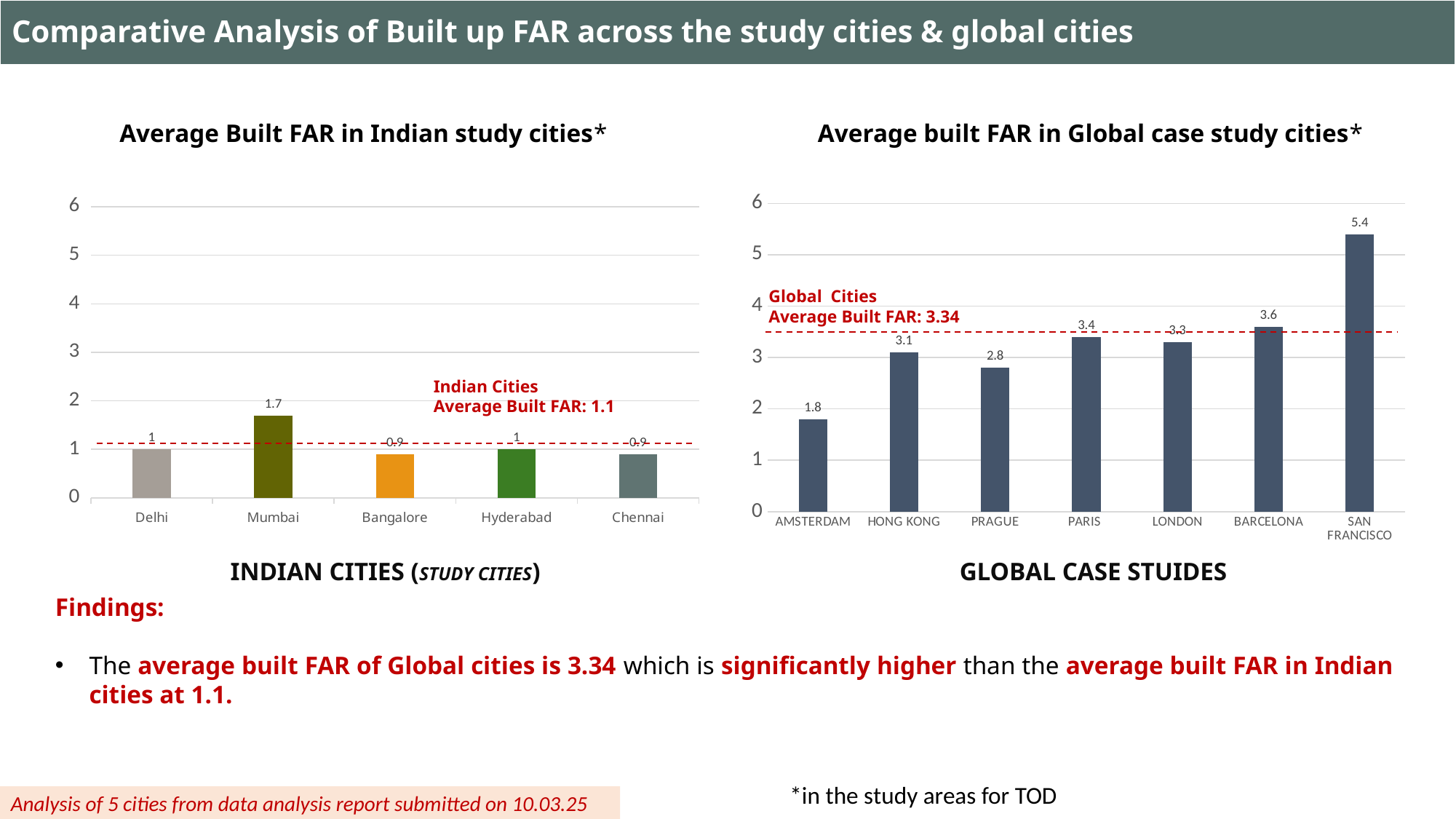
In the 'Average built FAR in Global case study cities' chart, how many cities are shown? 7 In the 'Average built FAR in Global case study cities' chart, which city has the lowest value? Amsterdam In the 'Average built FAR in Global case study cities' chart, what is the value for San Francisco? 5.4 In the 'Average built FAR in Global case study cities' chart, which is larger, Hong Kong or Barcelona? Barcelona In the 'Average Built FAR in Indian study cities' chart, what is the difference between Mumbai and Delhi? 0.7 In the 'Average Built FAR in Indian study cities' chart, which city has the highest value? Mumbai In the 'Average Built FAR in Indian study cities' chart, how many cities are shown? 5 In the 'Average Built FAR in Indian study cities' chart, what is the value for Mumbai? 1.7 In the 'Average built FAR in Global case study cities' chart, what is the difference between San Francisco and Amsterdam? 3.6 In the 'Average built FAR in Global case study cities' chart, what is the value for Prague? 2.8 What type of chart is the 'Average built FAR in Global case study cities' chart? Bar chart In the 'Average built FAR in Global case study cities' chart, which city has the highest value? San Francisco